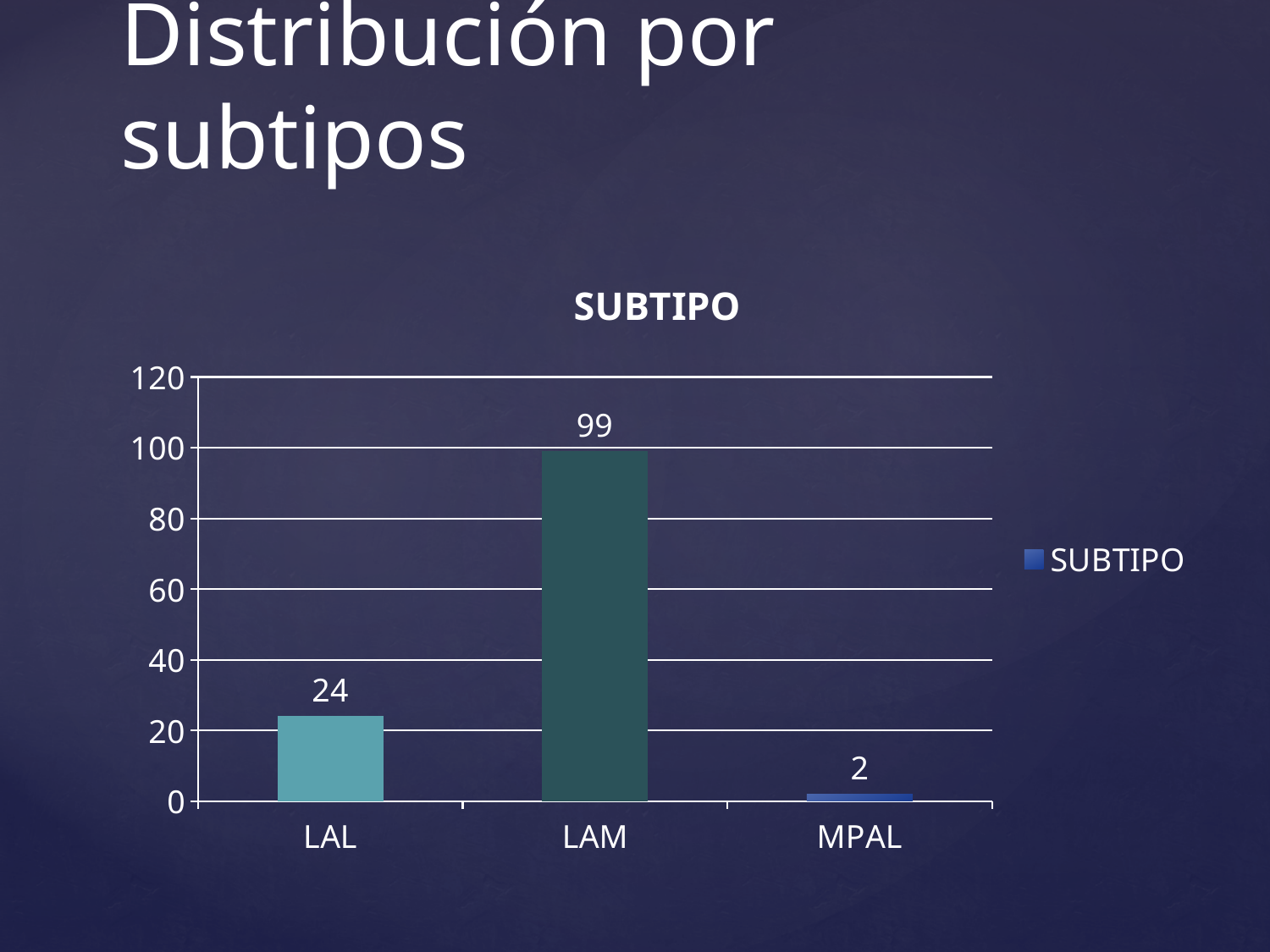
Which is larger, the value for LAL or the value for MPAL? LAL What is the difference between the values for LAM and LAL? 75 What is the value for LAL? 24 Which category has the lowest value? MPAL What is the difference between the values for LAL and MPAL? 22 What is the value for MPAL? 2 What is the title of the chart? SUBTIPO What is the value for LAM? 99 Which category has the highest value? LAM What kind of chart is shown on the slide? bar chart How many categories are shown on the x axis? 3 Is the value for LAM greater or less than 80? greater